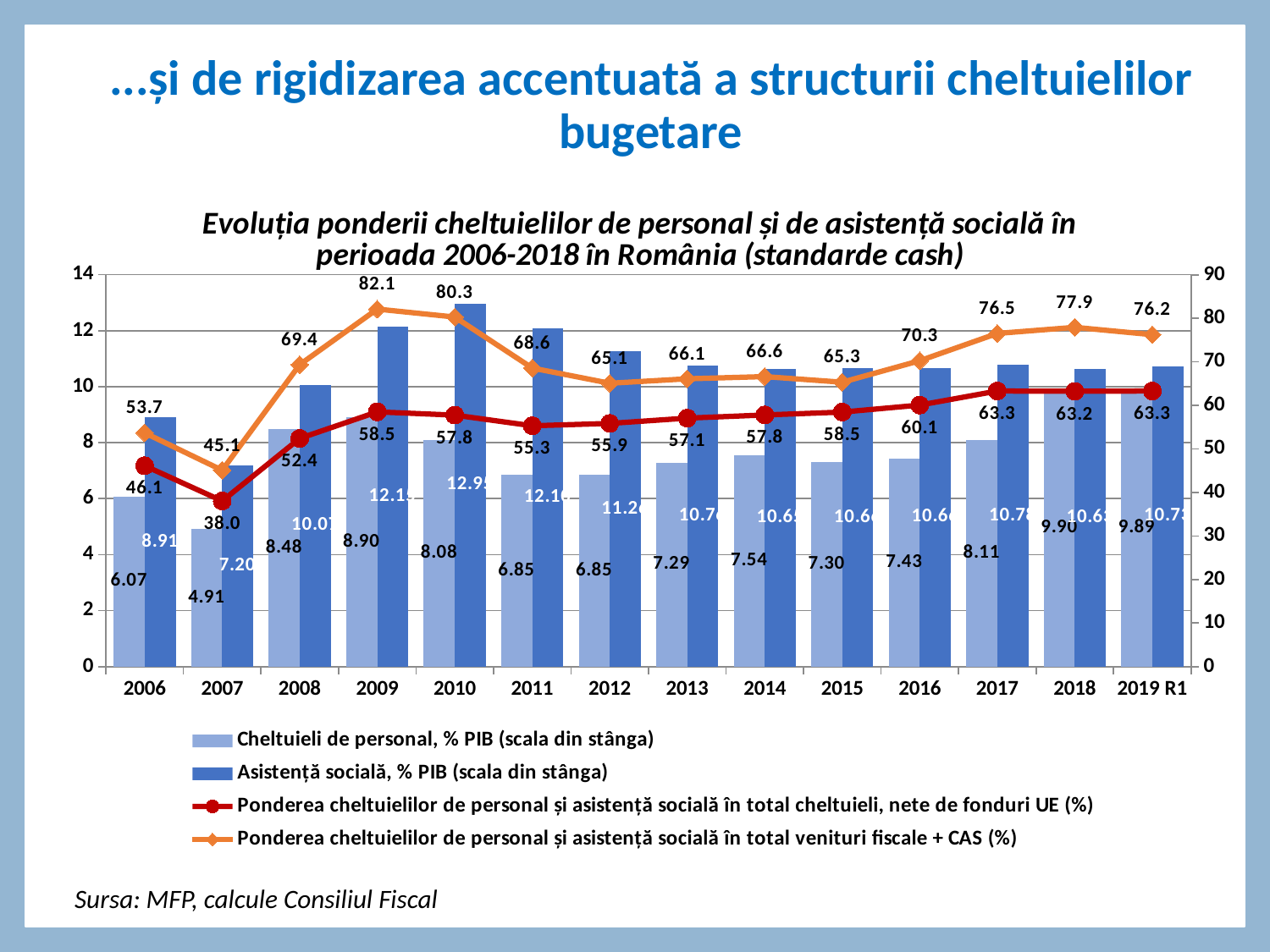
What is the value of Cheltuieli de personal, % PIB in 2007? 4.91 How many years are shown on the x axis of the chart? 14 What is the value of Ponderea cheltuielilor de personal și asistență socială în total cheltuieli, nete de fonduri UE (%) in 2016? 60.1 Is the value of Asistență socială, % PIB in 2010 greater or less than 12? greater In which year does the Ponderea cheltuielilor de personal și asistență socială în total venituri fiscale + CAS (%) line reach its highest value? 2009 In which year is the Ponderea cheltuielilor de personal și asistență socială în total cheltuieli, nete de fonduri UE (%) line at its lowest? 2007 What is the difference between Cheltuieli de personal, % PIB in 2018 and in 2006? 3.83 Which year has the larger value for Cheltuieli de personal, % PIB: 2009 or 2010? 2009 What kind of chart is shown on the slide? Combined bar and line chart How many series does the legend list? 4 What is the difference between the Ponderea cheltuielilor de personal și asistență socială în total venituri fiscale + CAS (%) values in 2009 and 2007? 37.0 What is the value of Ponderea cheltuielilor de personal și asistență socială în total venituri fiscale + CAS (%) in 2009? 82.1